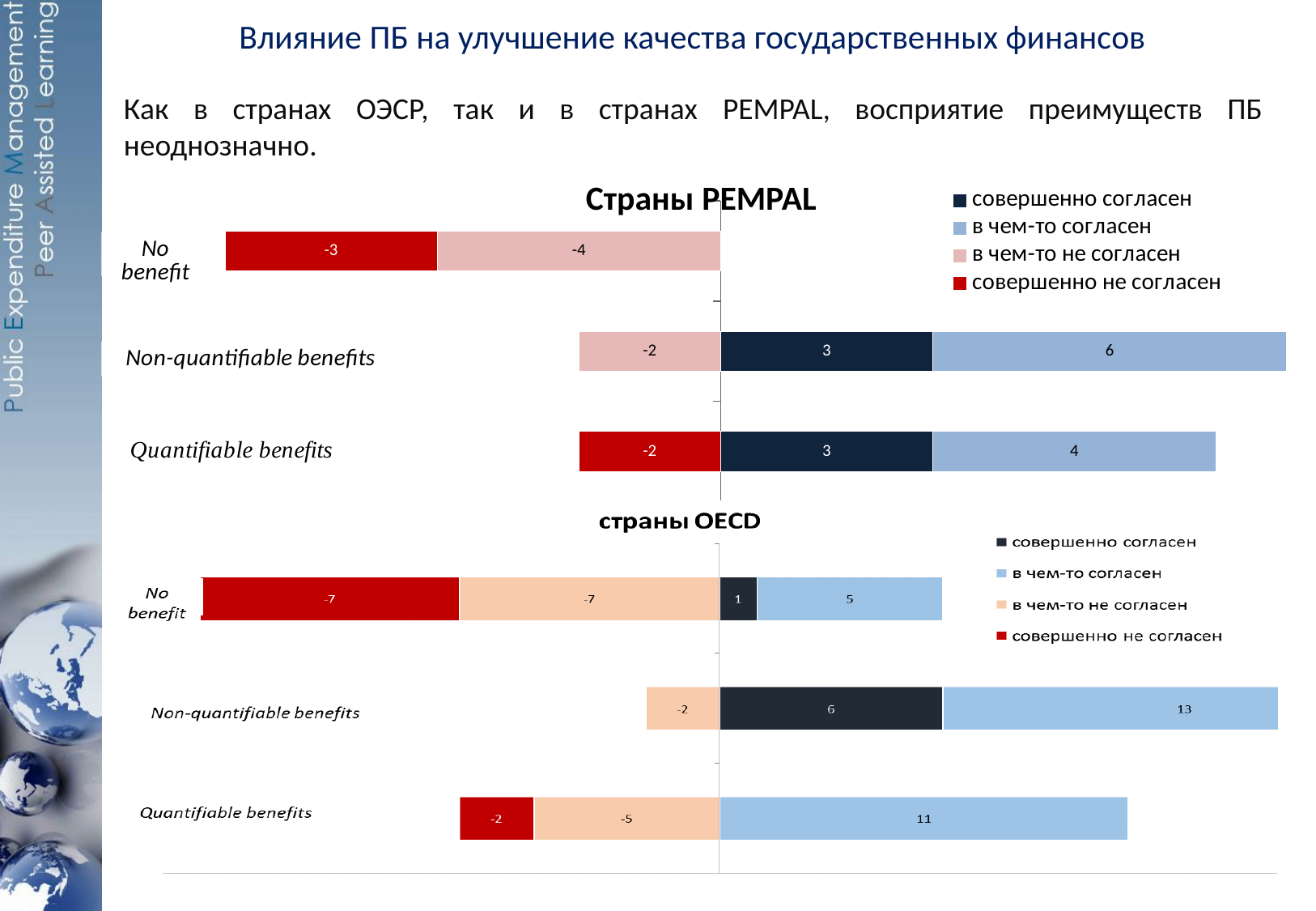
In the 'страны OECD' chart, which category has the highest value for 'в чем-то согласен'? Non-quantifiable benefits In the 'Страны PEMPAL' chart, what is the value of 'совершенно согласен' for Quantifiable benefits? 3 In the 'страны OECD' chart, what is the value of 'в чем-то согласен' for Non-quantifiable benefits? 13 In the 'страны OECD' chart, what is the value of 'совершенно согласен' for No benefit? 1 In the 'страны OECD' chart, what is the value of 'в чем-то не согласен' for Quantifiable benefits? -5 How many categories are shown in the 'страны OECD' chart? 3 In the 'Страны PEMPAL' chart, which is larger: the 'в чем-то согласен' value for Non-quantifiable benefits or for Quantifiable benefits? Non-quantifiable benefits In the 'страны OECD' chart, what is the difference between the 'в чем-то согласен' values for Non-quantifiable benefits and Quantifiable benefits? 2 In the 'Страны PEMPAL' chart, what is the value of 'в чем-то не согласен' for No benefit? -4 What kind of chart is the 'страны OECD' chart? Stacked bar chart How many series does the legend of the 'Страны PEMPAL' chart list? 4 In the 'Страны PEMPAL' chart, what is the value of 'в чем-то согласен' for Non-quantifiable benefits? 6